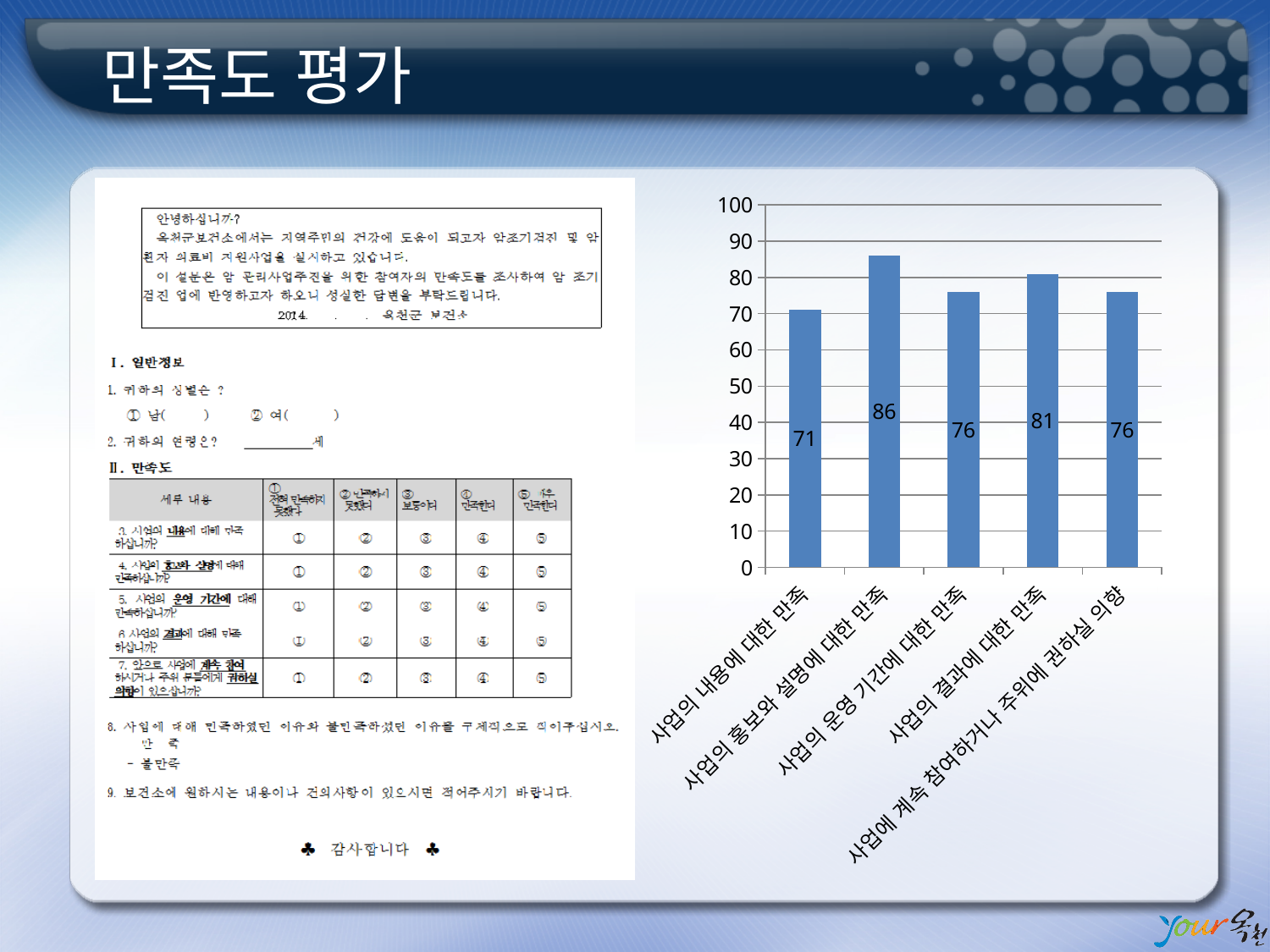
How many categories are shown in the chart? 5 Is the value for 사업의 내용에 대한 만족 greater or less than 80? less What is the difference between the values for 사업의 홍보와 설명에 대한 만족 and 사업의 내용에 대한 만족? 15 Which is larger, the value for 사업의 결과에 대한 만족 or the value for 사업의 운영 기간에 대한 만족? 사업의 결과에 대한 만족 What is the value for 사업의 내용에 대한 만족? 71 What is the value for 사업의 홍보와 설명에 대한 만족? 86 What is the value for 사업에 계속 참여하거나 주위에 권하실 의향? 76 Which category has the lowest value? 사업의 내용에 대한 만족 What is the difference between the values for 사업의 결과에 대한 만족 and 사업의 운영 기간에 대한 만족? 5 Which category has the highest value? 사업의 홍보와 설명에 대한 만족 What is the value for 사업의 결과에 대한 만족? 81 What kind of chart is shown on the slide? bar chart